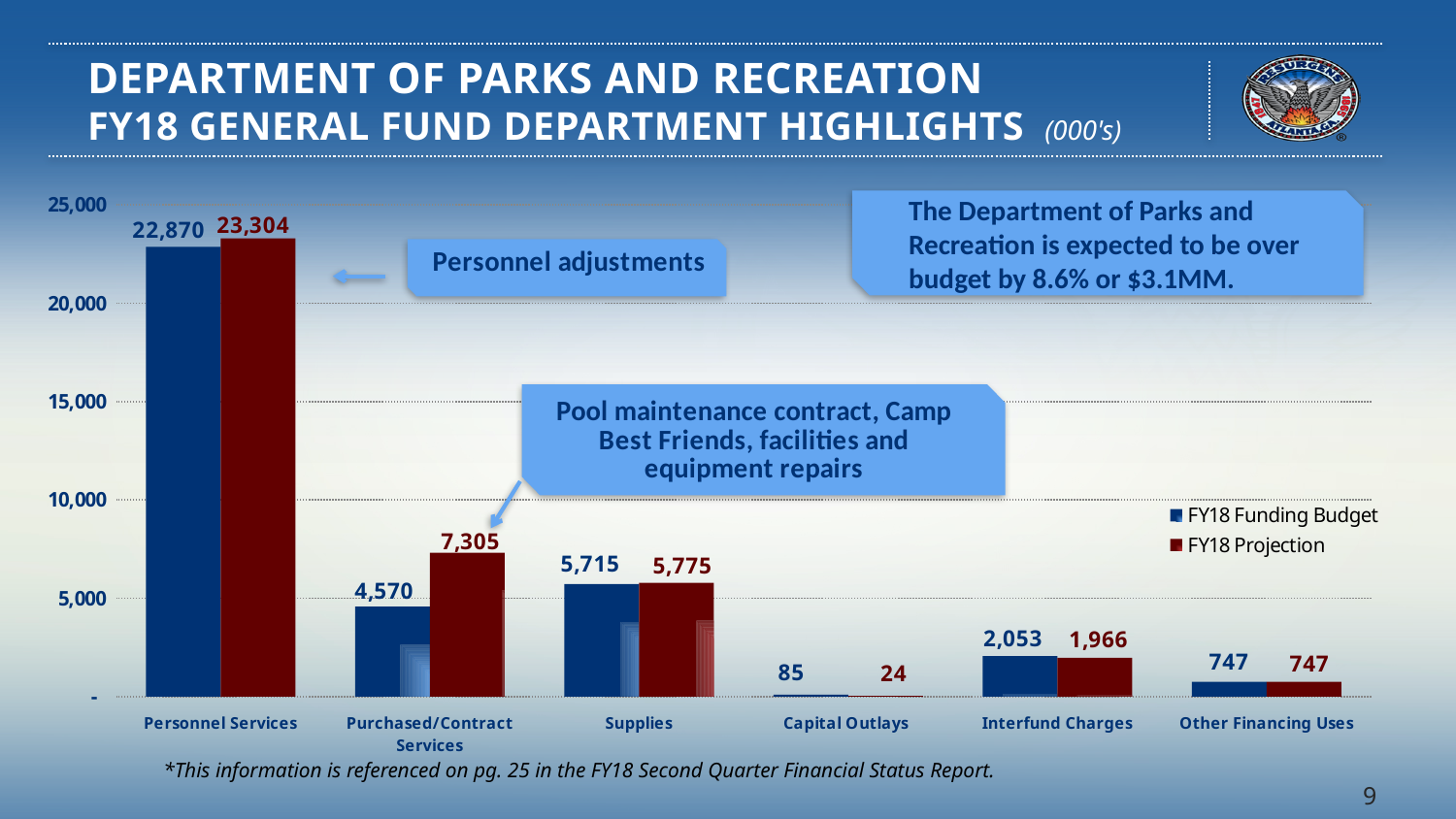
What is the difference between the FY18 Projection and the FY18 Funding Budget for Purchased/Contract Services? 2,735 How many categories are shown on the x axis of the chart? 6 Which is larger for Interfund Charges, the FY18 Funding Budget or the FY18 Projection? FY18 Funding Budget What is the FY18 Projection value for Capital Outlays? 24 Is the FY18 Projection value for Supplies greater or less than 5,000? greater What is the FY18 Funding Budget value for Interfund Charges? 2,053 Which category has the highest FY18 Projection value? Personnel Services How many series does the chart legend list? 2 What is the FY18 Funding Budget value for Personnel Services? 22,870 What type of chart is shown on the slide? Bar chart What is the FY18 Projection value for Purchased/Contract Services? 7,305 Which category has the lowest FY18 Funding Budget value? Capital Outlays